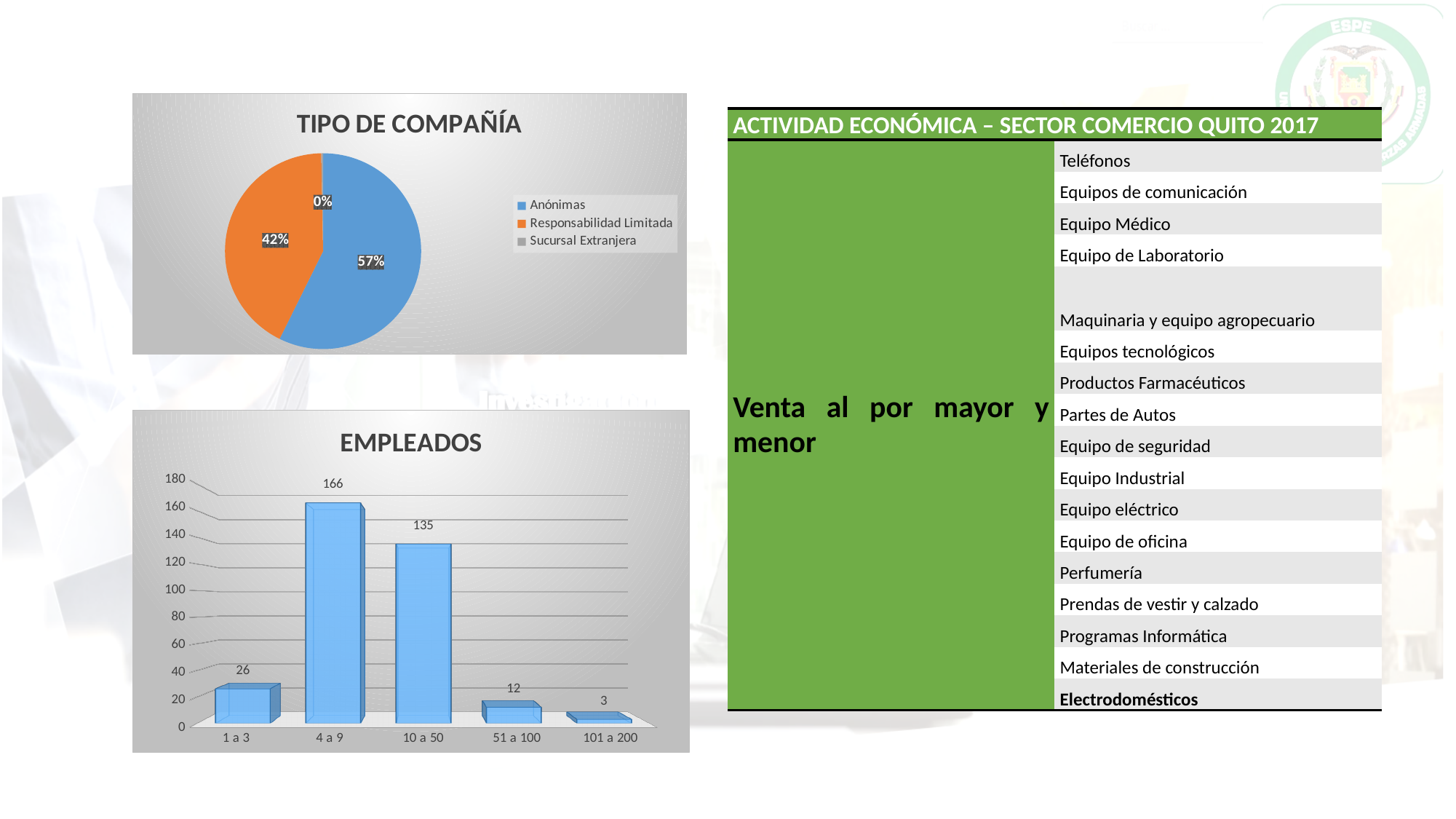
In the TIPO DE COMPAÑÍA chart, what share of the pie is Anónimas? 57% What kind of chart is the EMPLEADOS chart? Bar chart In the TIPO DE COMPAÑÍA chart, what share of the pie is Responsabilidad Limitada? 42% In the TIPO DE COMPAÑÍA chart, which category has the largest slice? Anónimas In the EMPLEADOS chart, what is the value for 10 a 50? 135 In the EMPLEADOS chart, which category has the lowest value? 101 a 200 In the EMPLEADOS chart, how many categories are shown on the x axis? 5 In the TIPO DE COMPAÑÍA chart, what share of the pie is Sucursal Extranjera? 0% What kind of chart is the TIPO DE COMPAÑÍA chart? Pie chart In the EMPLEADOS chart, what is the difference between the values for 4 a 9 and 10 a 50? 31 In the EMPLEADOS chart, what is the value for 4 a 9? 166 In the TIPO DE COMPAÑÍA chart, how many entries does the legend list? 3